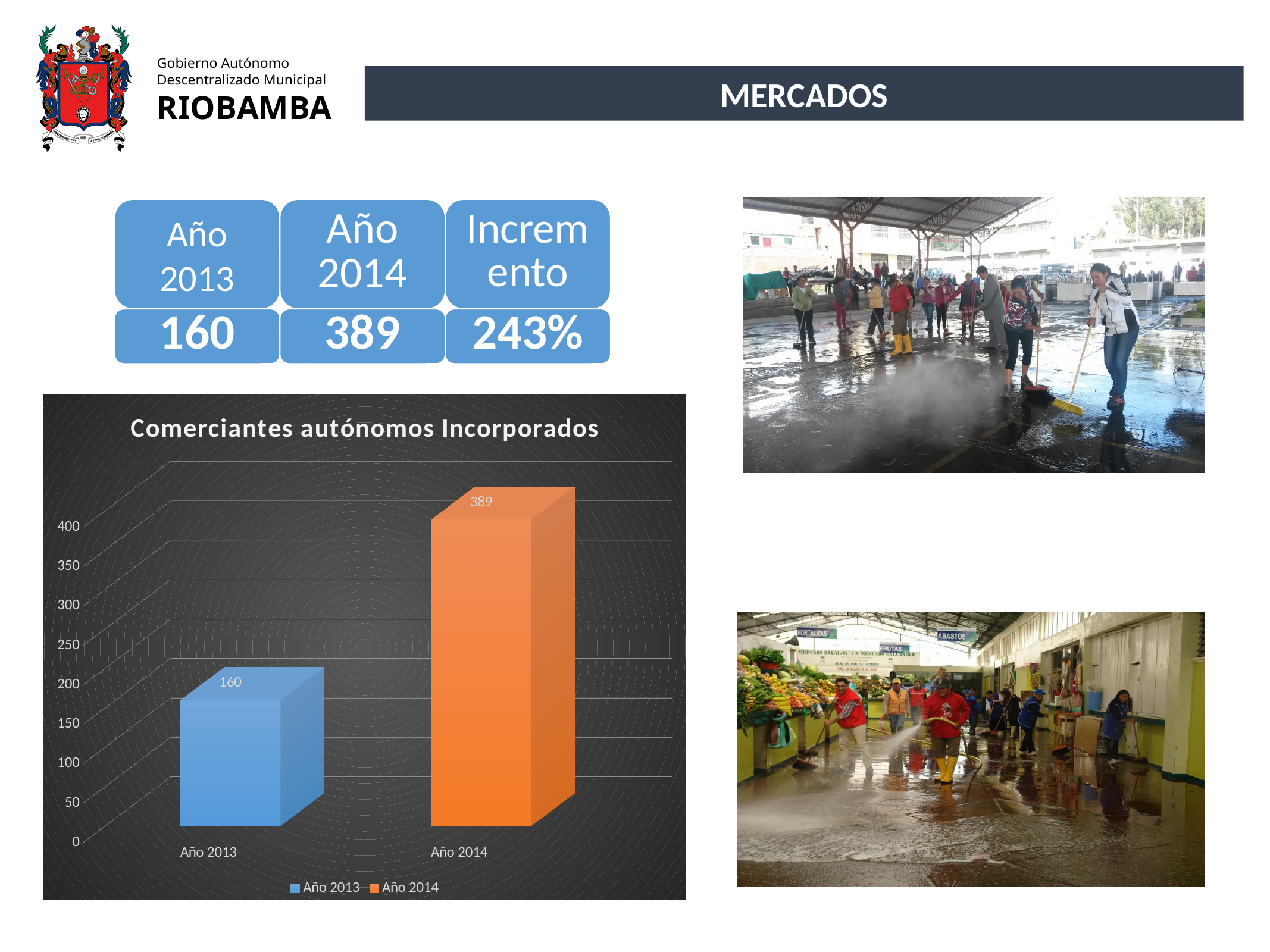
Is the value for Año 2013 greater or less than 200? less What is the value for Año 2013 in the chart? 160 How many categories are shown on the x axis of the chart? 2 What is the title of the chart? Comerciantes autónomos Incorporados Which category has the lowest value in the chart? Año 2013 What is the value for Año 2014 in the chart? 389 Is the value for Año 2014 greater or less than 350? greater What is the difference between the values for Año 2014 and Año 2013? 229 Which category has the highest value in the chart? Año 2014 How many entries does the chart legend list? 2 What kind of chart is shown on the slide? Bar chart Which is larger, the value for Año 2013 or the value for Año 2014? Año 2014